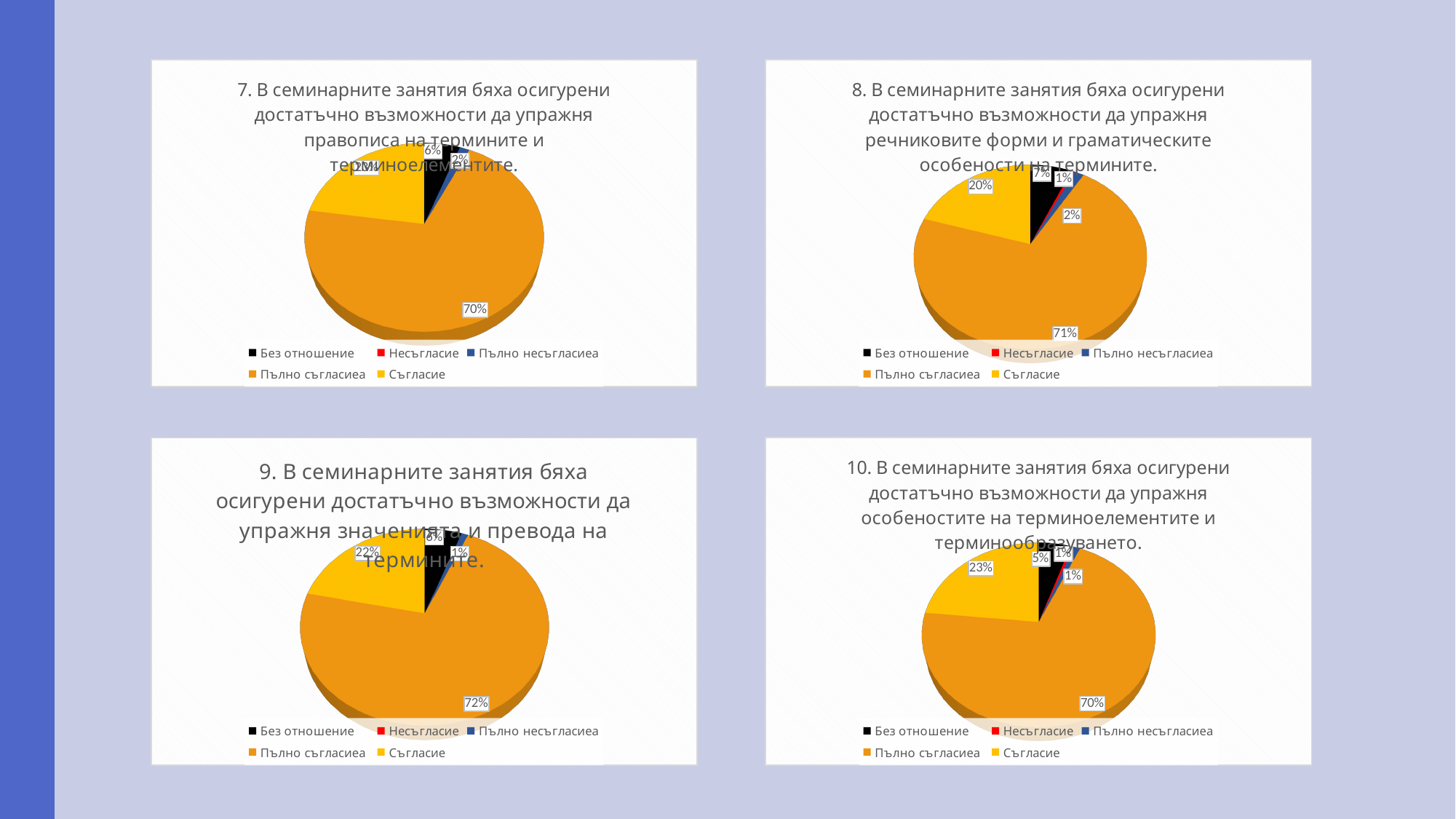
In the top-left chart (question 7), what percentage is shown for Без отношение? 6% What type of chart is used for question 9 (bottom-left)? Pie chart In the bottom-right chart (question 10), what percentage is shown for Съгласие? 23% In the bottom-right chart (question 10), which is larger: the share for Без отношение or the share for Съгласие? Съгласие In the bottom-left chart (question 9), what percentage is shown for Пълно съгласиеа? 72% In the top-left chart (question 7), what percentage is shown for Пълно съгласиеа? 70% In the bottom-right chart (question 10), which category has the largest share? Пълно съгласиеа In the top-right chart (question 8), what percentage is shown for Пълно съгласиеа? 71% In the top-right chart (question 8), which category has the smallest share? Несъгласие How many categories does the legend of the top-left chart (question 7) list? 5 In the top-right chart (question 8), what percentage is shown for Съгласие? 20% In the bottom-left chart (question 9), what is the difference between the shares for Пълно съгласиеа and Съгласие? 50 percentage points